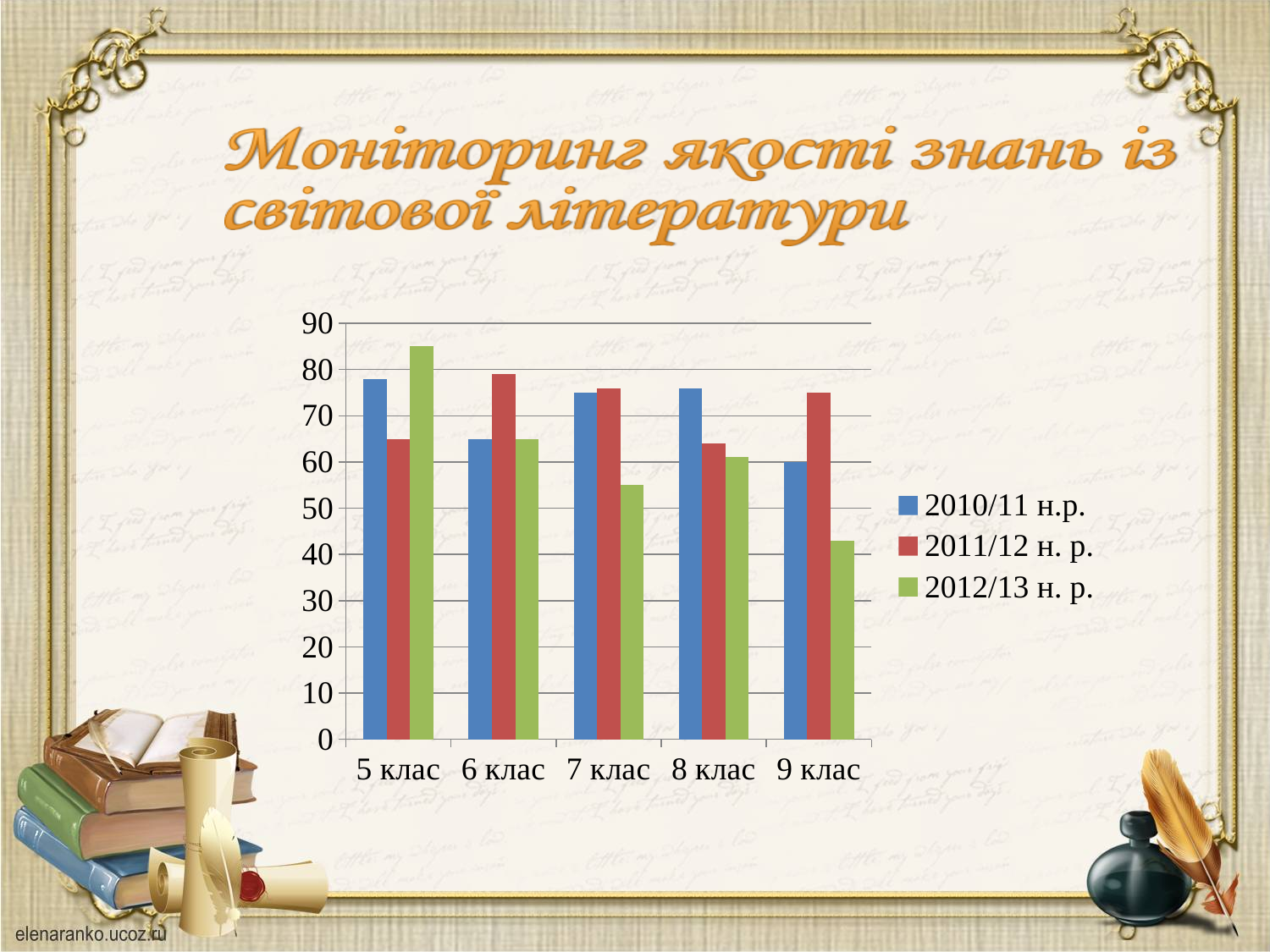
Which class has the lowest value for the 2012/13 н. р. series? 9 клас Which colour represents the 2012/13 н. р. series in the legend? green How many classes (categories) are shown on the x axis? 5 How many series does the legend list? 3 Is the 2012/13 н. р. value for 7 клас greater or less than 60? less Is the 2011/12 н. р. value for 6 клас greater or less than 70? greater For 9 клас, which series has the larger value: 2011/12 н. р. or 2012/13 н. р.? 2011/12 н. р. Is the 2012/13 н. р. value for 5 клас greater or less than 80? greater What kind of chart is shown on the slide? bar chart For 8 клас, which series has the larger value: 2010/11 н.р. or 2011/12 н. р.? 2010/11 н.р. Which class has the highest value for the 2012/13 н. р. series? 5 клас